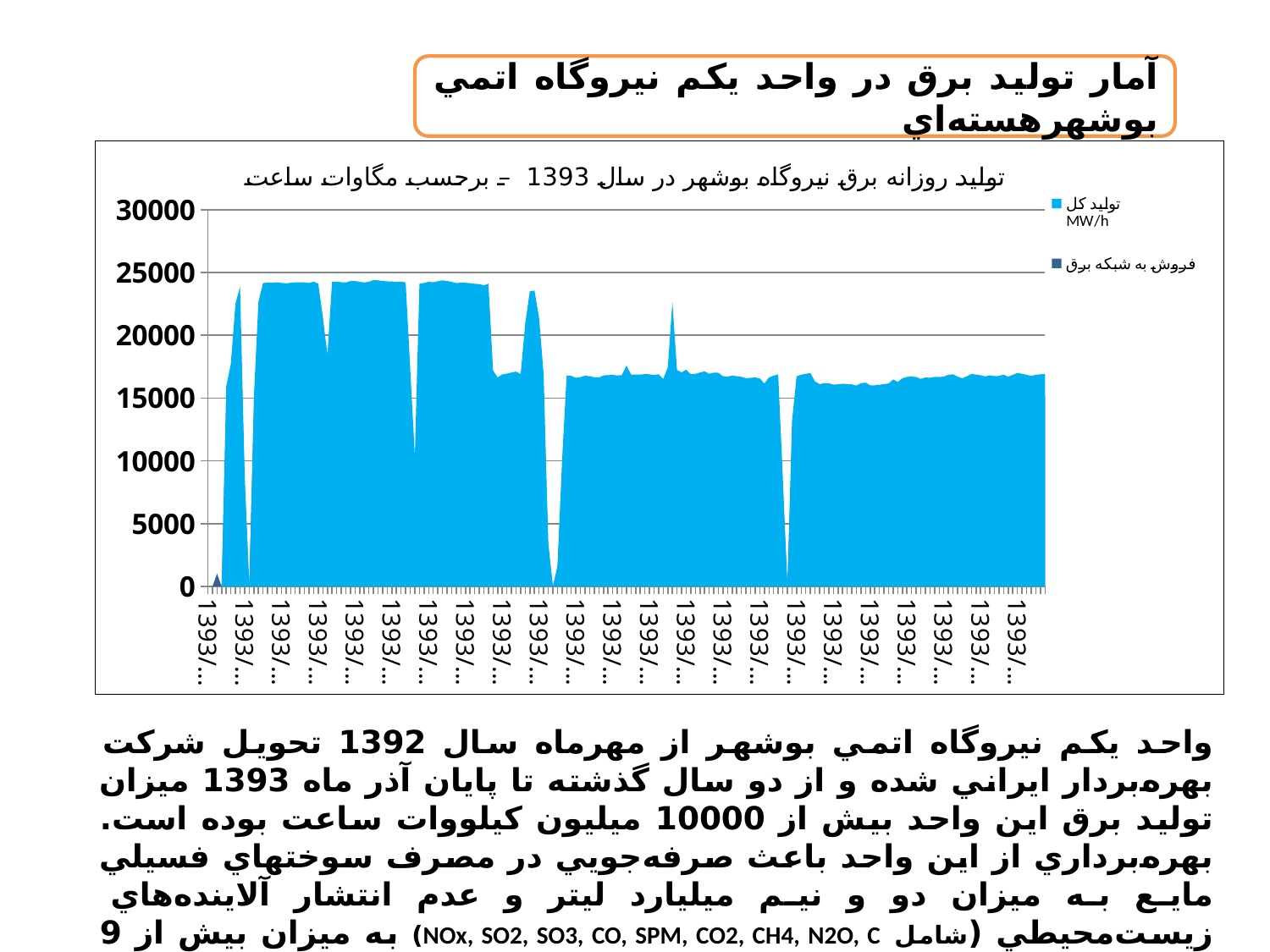
What is the first legend entry of the chart? تولید کل MW/h Which year do the x-axis labels of the chart refer to? 1393 What is the title of the chart? تولید روزانه برق نیروگاه بوشهر در سال 1393 - برحسب مگاوات ساعت Is the peak value of the total production series greater or less than 20000? greater What kind of chart is shown on the slide? Area chart How many series does the chart legend list? 2 What is the highest tick value shown on the chart's vertical axis? 30000 Is the peak value of the total production series greater or less than 25000? less